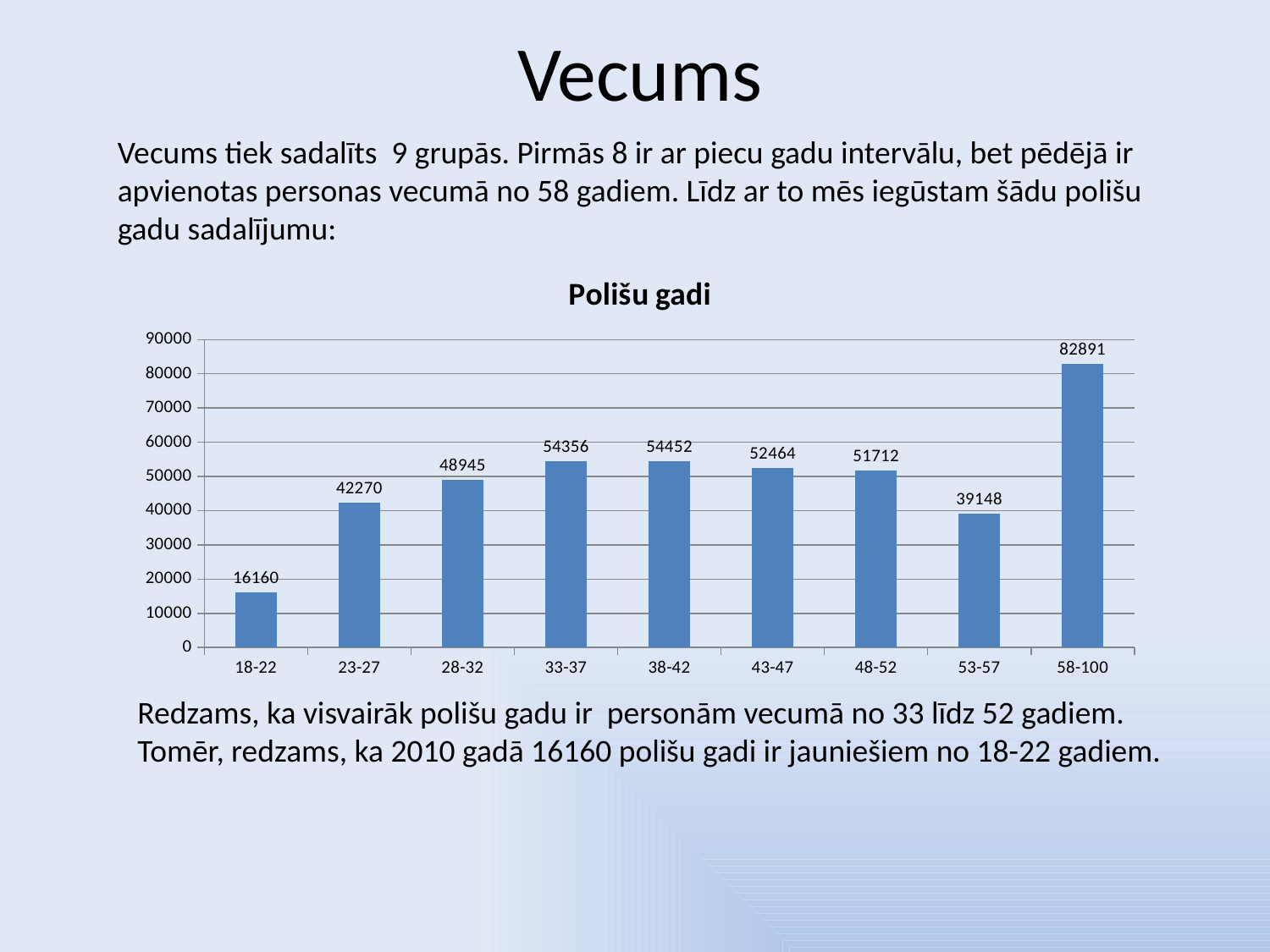
Is the value for 23-27 greater or less than 40000? greater What is the difference between the values for 33-37 and 28-32? 5411 What is the value for the 18-22 age group? 16160 Which age group has the highest value? 58-100 What is the value for the 53-57 age group? 39148 What is the title of the chart? Polišu gadi How many age groups are shown on the chart? 9 What is the value for the 58-100 age group? 82891 What is the difference between the values for 58-100 and 18-22? 66731 Which is larger, the value for 43-47 or the value for 48-52? 43-47 Which age group has the lowest value? 18-22 What kind of chart is shown on the slide? bar chart